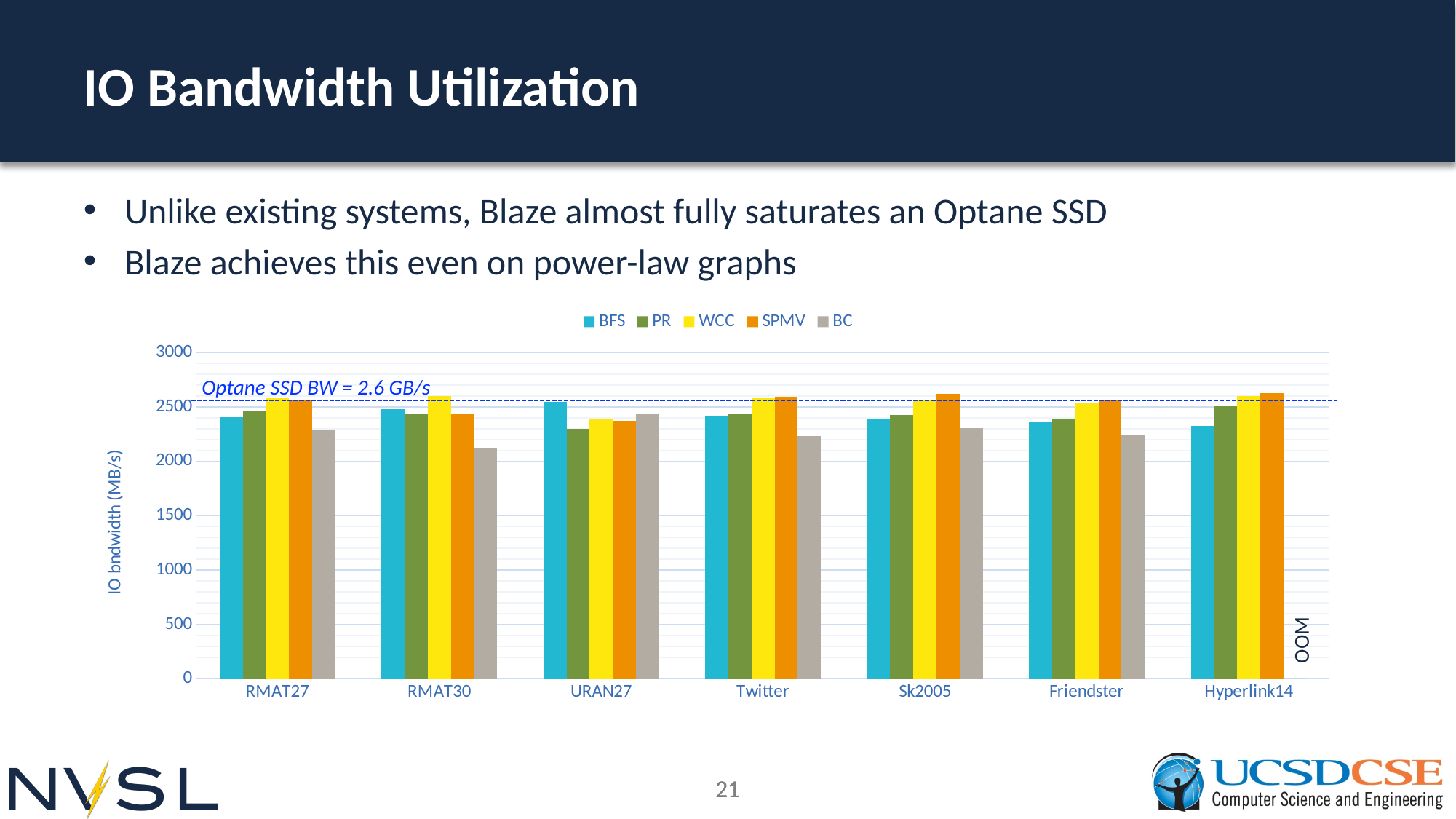
What label appears in place of the BC bar for Hyperlink14? OOM For URAN27, which is larger, the BFS value or the PR value? BFS Is the SPMV value for Sk2005 greater or less than 2500? greater Is the BC value for Twitter greater or less than 2000? greater For RMAT30, which is larger, the BFS value or the BC value? BFS Which series has the lowest value for Twitter? BC Is the PR value for URAN27 greater or less than 2500? less What kind of chart is shown on the slide? bar chart How many series does the legend list? 5 How many graph categories are shown along the x axis? 7 What does the label on the dashed horizontal line say? Optane SSD BW = 2.6 GB/s